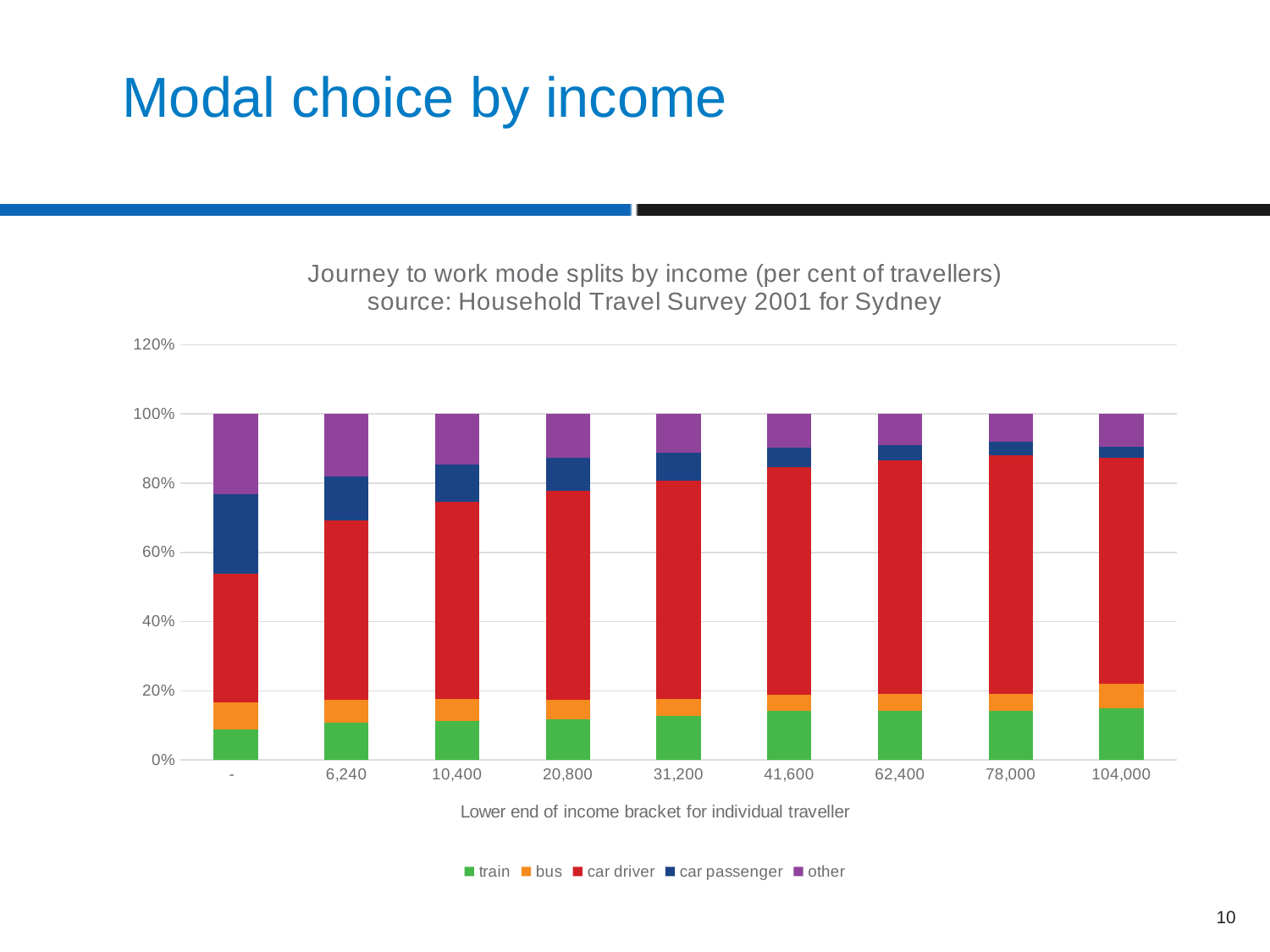
Which is larger: the 'train' share for the '-' bracket or the 'train' share for the 104,000 bracket? 104,000 Is the 'car passenger' share for the '-' income bracket greater or less than 20%? greater How many series does the legend list? 5 What is the total of the stacked bar for the 41,600 income bracket? 100% What is the x-axis label of the chart? Lower end of income bracket for individual traveller Which income bracket has the largest 'car passenger' share? - Does the 'car driver' share generally rise or fall as income increases along the x axis? rise How many income brackets are shown along the x axis? 9 Which income bracket has the largest 'other' share? - Is the 'car driver' share for the 78,000 income bracket greater or less than 60%? greater Is the 'train' share for the 104,000 income bracket greater or less than 20%? less What kind of chart is shown on the slide? Stacked bar chart